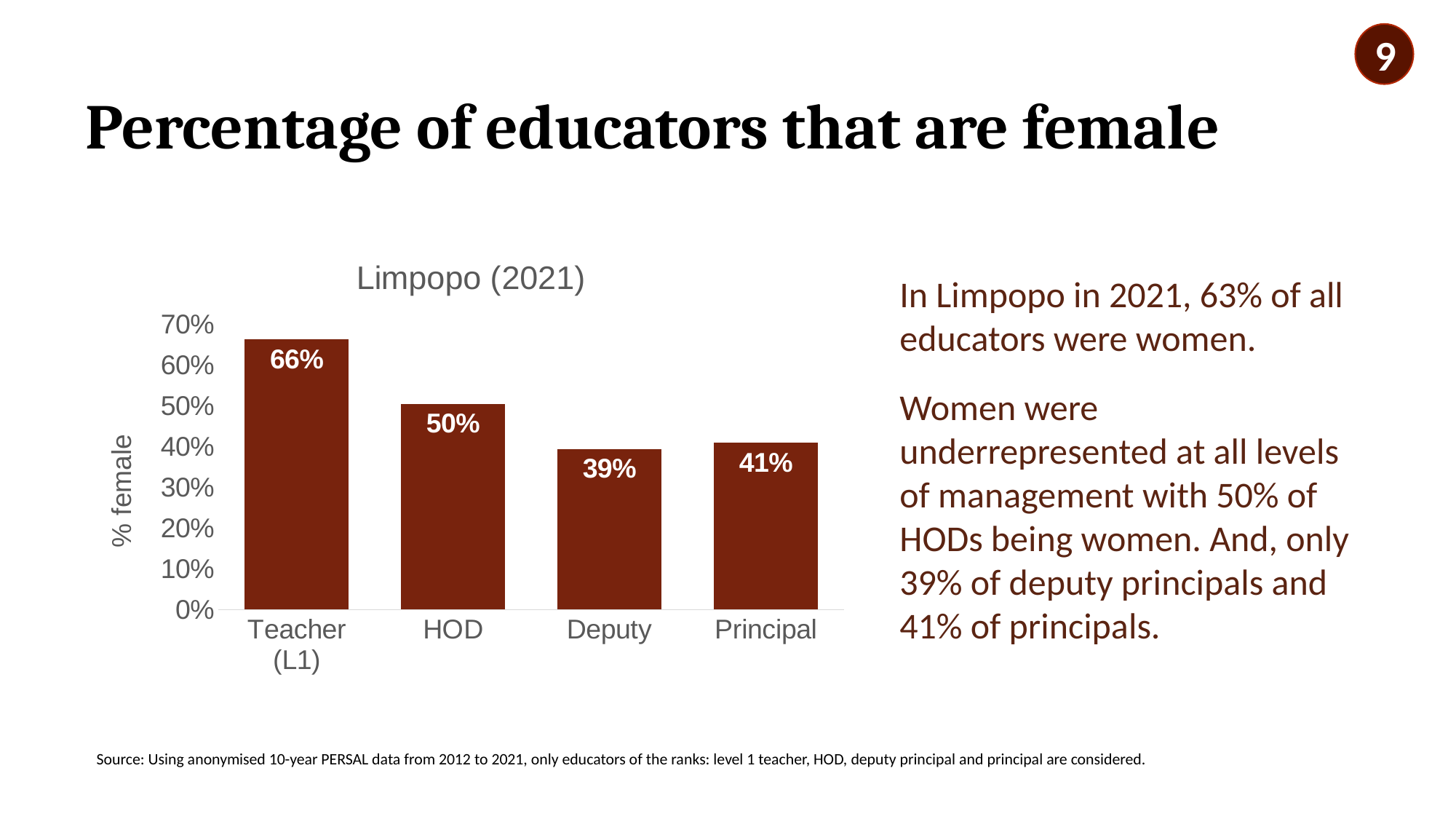
Which category has the highest percentage of female educators? Teacher (L1) What is the percentage of female educators for Deputy? 39% What kind of chart is shown on the slide? Bar chart What is the percentage of female educators for Principal? 41% Which is larger, the value for Principal or the value for Deputy? Principal What is the percentage of female educators for Teacher (L1)? 66% Is the value for HOD greater or less than 40%? greater What is the difference in percentage points between Teacher (L1) and HOD? 16 Which category has the lowest percentage of female educators? Deputy What is the title of the chart? Limpopo (2021) What is the percentage of female educators for HOD? 50% How many categories are shown on the x axis? 4